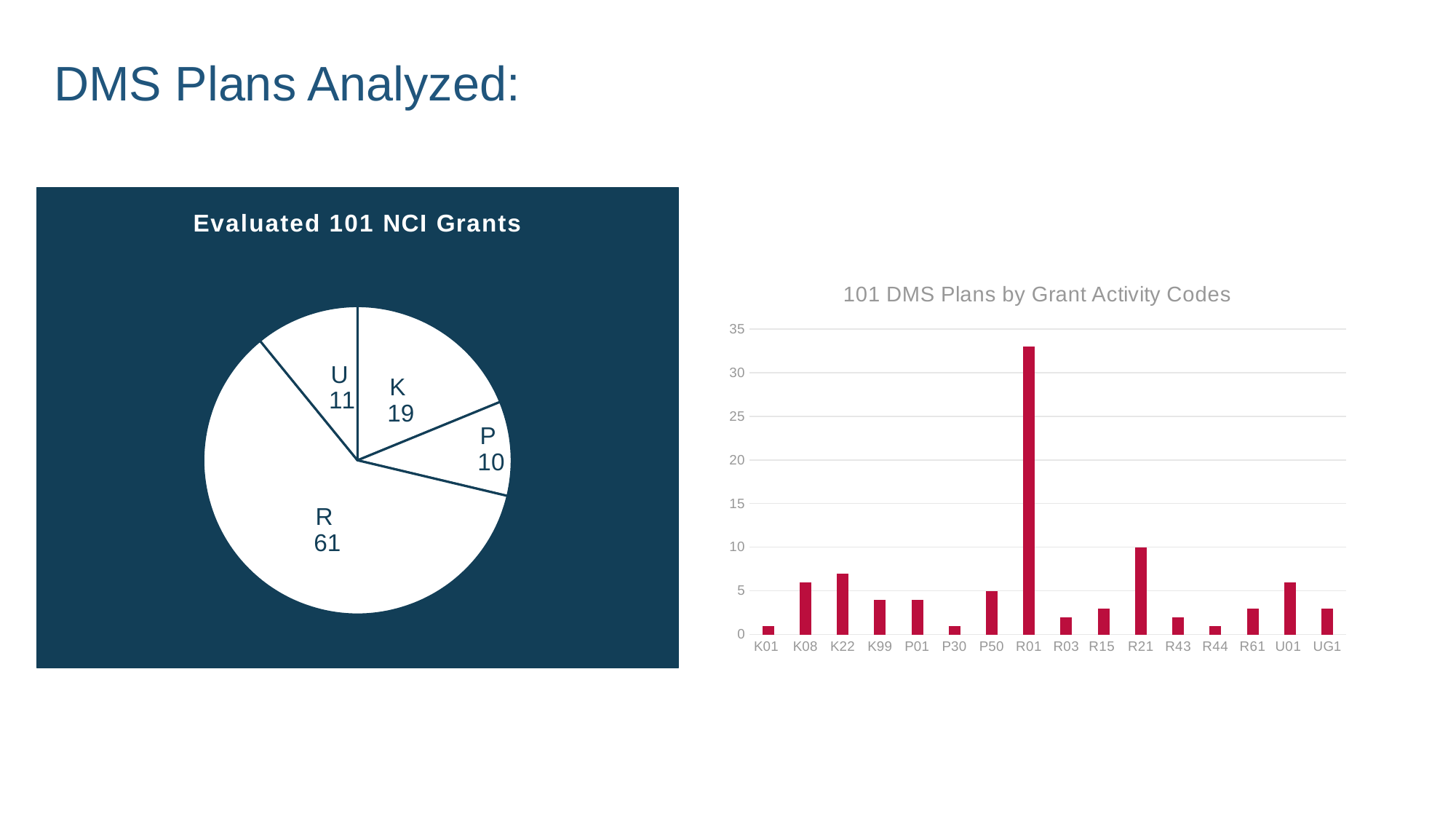
In the pie chart 'Evaluated 101 NCI Grants', which category has the smallest slice? P In the chart '101 DMS Plans by Grant Activity Codes', is the value for K22 greater or less than 10? less How many slices does the pie chart 'Evaluated 101 NCI Grants' have? 4 In the pie chart 'Evaluated 101 NCI Grants', what is the value for K? 19 In the pie chart 'Evaluated 101 NCI Grants', which is larger, U or P? U What kind of chart is '101 DMS Plans by Grant Activity Codes'? bar chart In the chart '101 DMS Plans by Grant Activity Codes', which activity code has the highest bar? R01 How many activity codes are shown on the x axis of the chart '101 DMS Plans by Grant Activity Codes'? 16 In the pie chart 'Evaluated 101 NCI Grants', which category has the largest slice? R In the pie chart 'Evaluated 101 NCI Grants', what is the value for R? 61 In the chart '101 DMS Plans by Grant Activity Codes', is the value for R01 greater or less than 30? greater In the pie chart 'Evaluated 101 NCI Grants', what is the difference between the values for K and U? 8